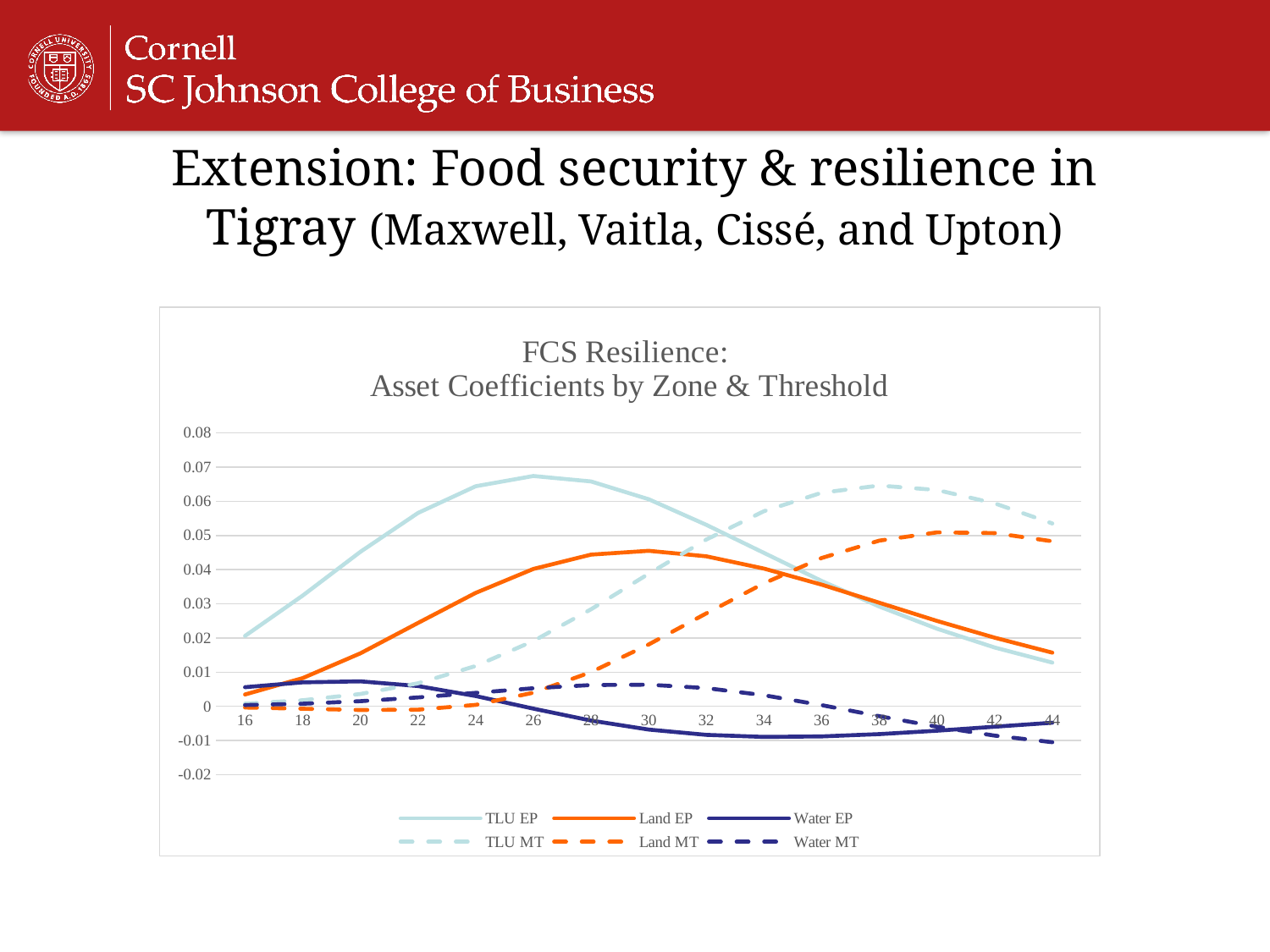
What is the title of the chart? FCS Resilience: Asset Coefficients by Zone & Threshold What kind of chart is shown on the slide? Line chart At x = 26, which series has a higher value, TLU EP or Land EP? TLU EP At x = 40, which series has a higher value, TLU MT or Land MT? TLU MT Does the TLU MT line rise or fall between x = 16 and x = 38? rise Which legend entries are drawn with dashed lines? TLU MT, Land MT, Water MT Is the value of TLU EP at x = 26 greater or less than 0.06? greater Is the value of Land MT at x = 30 greater or less than 0.01? greater How many series does the legend list? 6 How many x-axis tick values are shown on the chart? 15 Which series has the lowest value at x = 34? Water EP Is the value of Water EP at x = 34 greater or less than 0? less